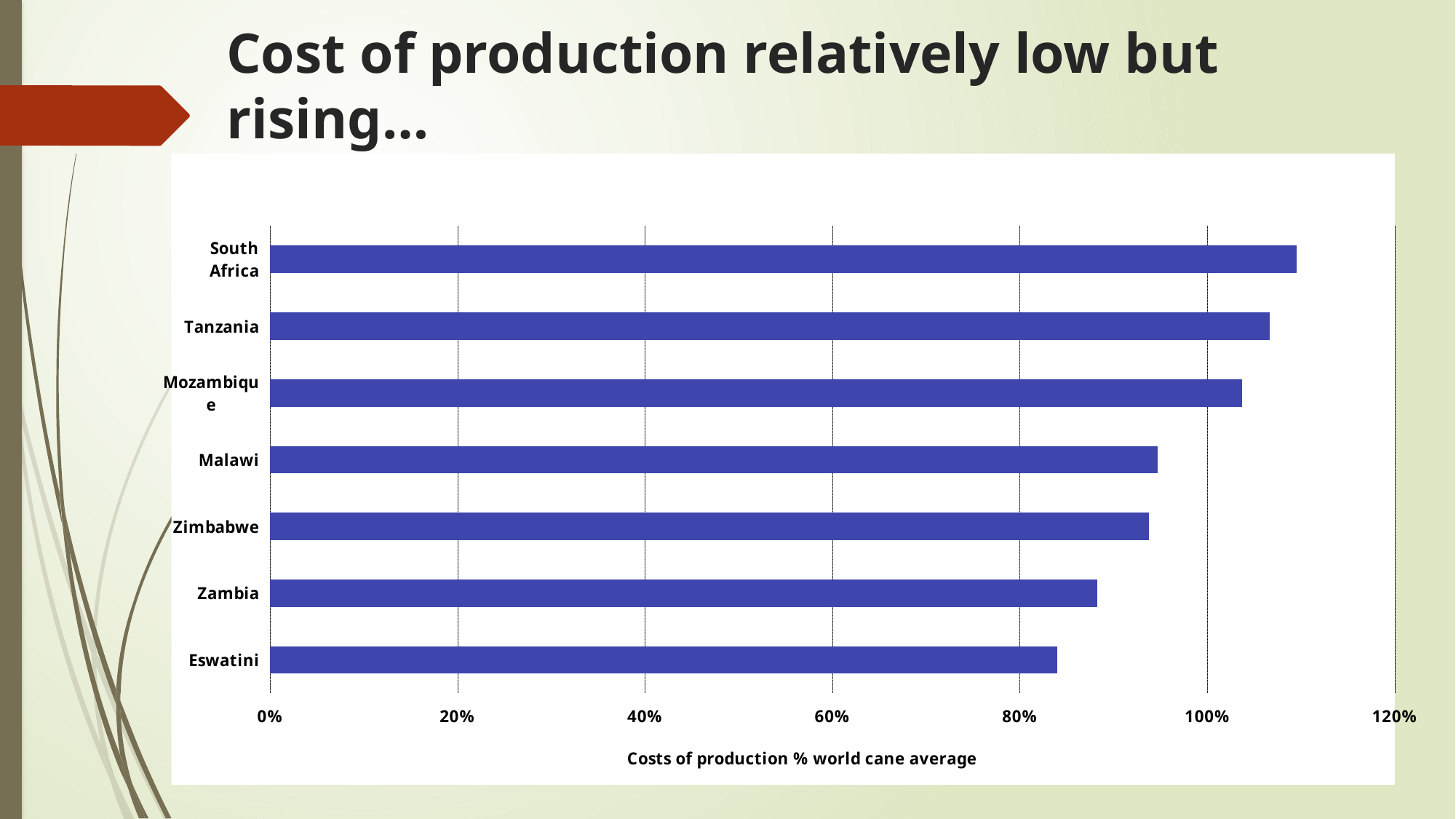
Which country has the lowest cost of production as a % of the world cane average? Eswatini What is the label on the horizontal axis of the chart? Costs of production % world cane average Is the value for Eswatini greater or less than 100%? less Is the value for Mozambique greater or less than 100%? greater Is the value for South Africa greater or less than 100%? greater Which has a higher cost of production relative to the world cane average, Tanzania or Zambia? Tanzania What kind of chart is shown on the slide? bar chart Which has a higher cost of production relative to the world cane average, Malawi or Mozambique? Mozambique How many countries are shown in the chart? 7 Which country has the highest cost of production as a % of the world cane average? South Africa